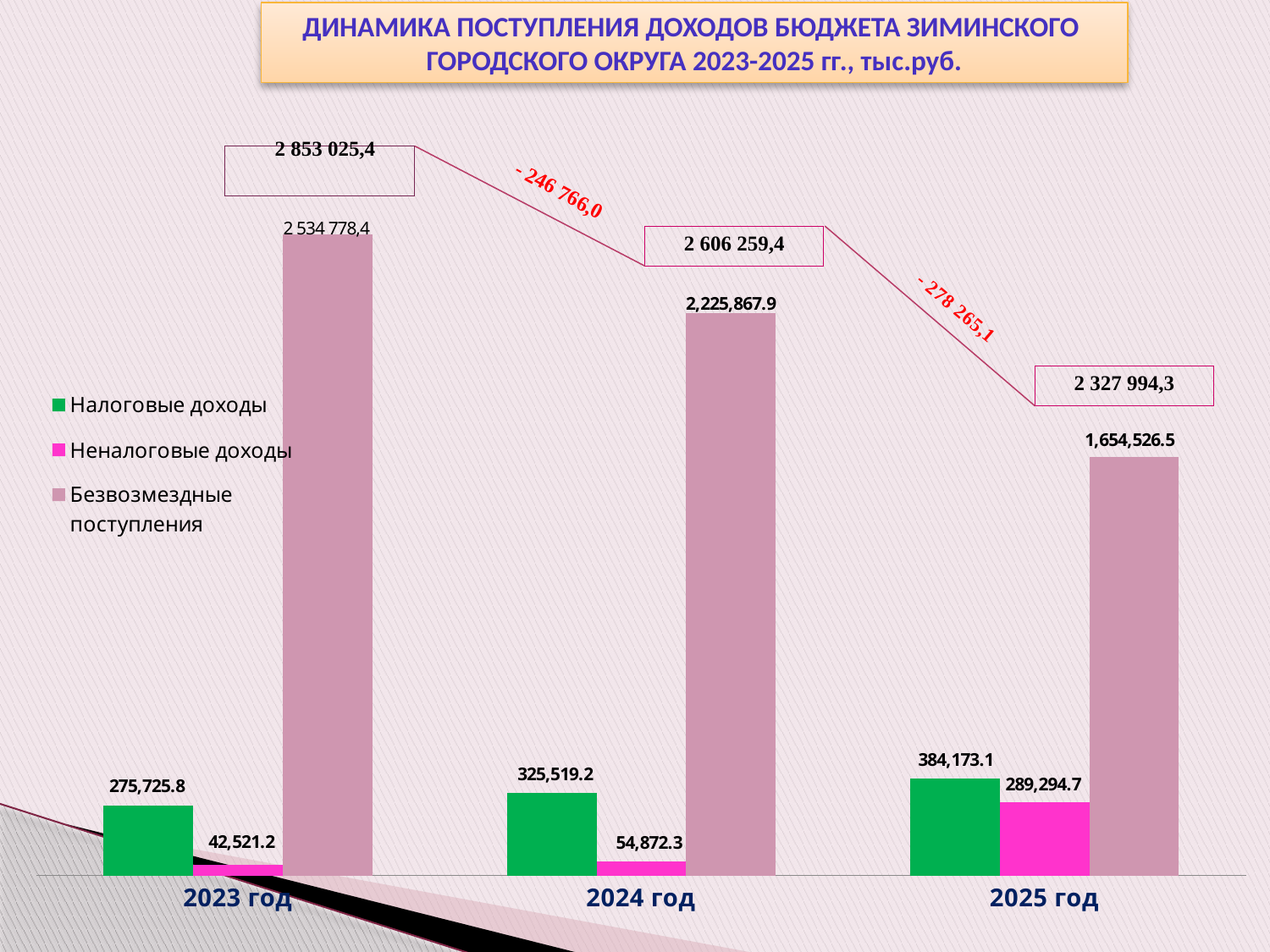
How many series does the legend list? 3 Which is larger in 2024 год: Налоговые доходы or Неналоговые доходы? Налоговые доходы What kind of chart is shown on the slide? bar chart What is the value of Неналоговые доходы for 2024 год? 54,872.3 What is the value of Налоговые доходы for 2023 год? 275,725.8 In which year is Налоговые доходы the lowest? 2023 год In which year is Безвозмездные поступления the highest? 2023 год Do the values of Безвозмездные поступления rise or fall from 2023 год to 2025 год? fall What is the value of Неналоговые доходы for 2025 год? 289,294.7 What is the value of Безвозмездные поступления for 2025 год? 1,654,526.5 How many year categories are shown on the x axis? 3 What total is shown in the box above the 2024 год group? 2 606 259,4